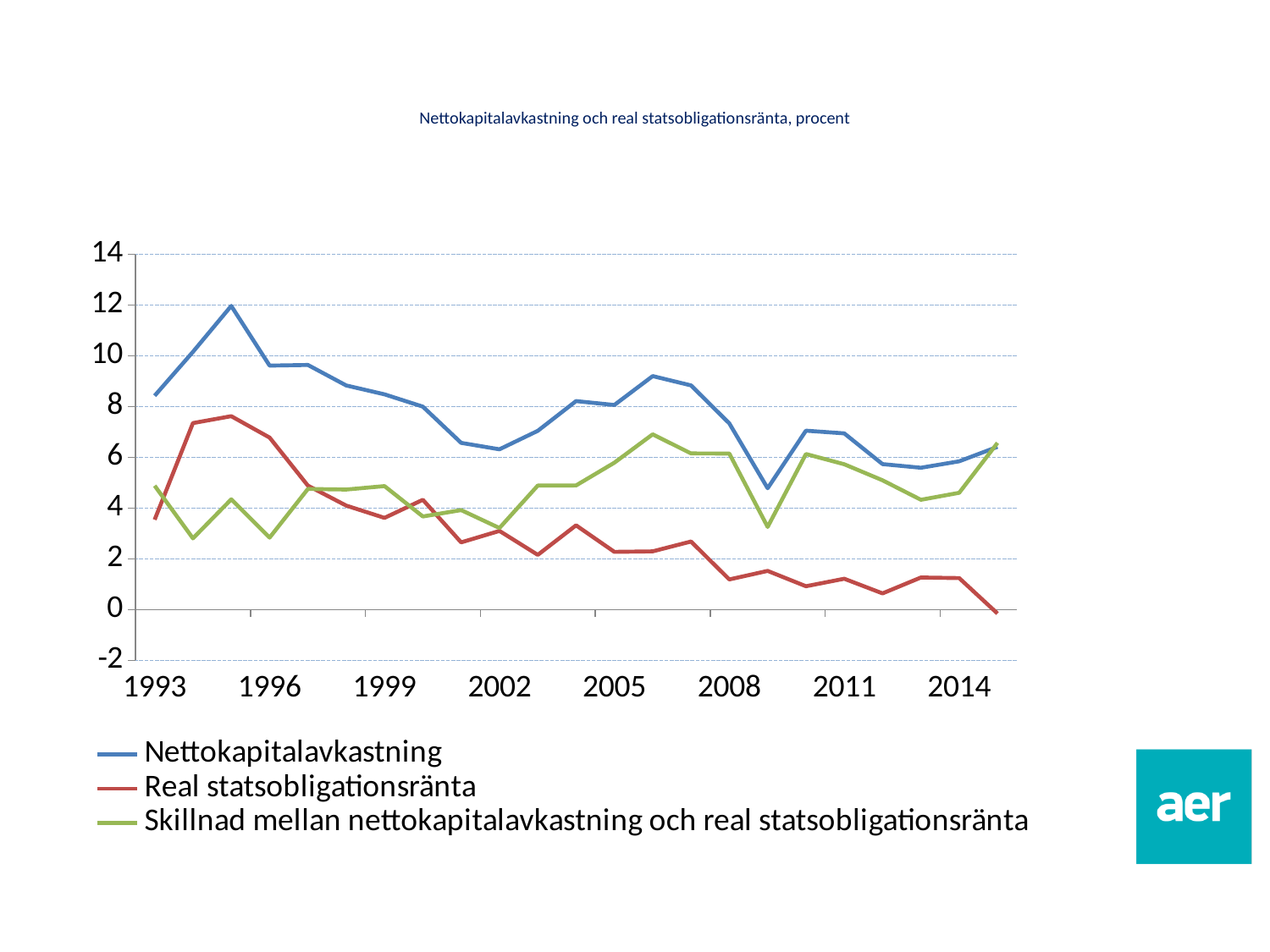
Is the value for Nettokapitalavkastning in 2009 greater or less than 6? less What kind of chart is shown on the slide? line chart Is the value for Real statsobligationsränta in 2008 greater or less than 2? less What is the title of the chart? Nettokapitalavkastning och real statsobligationsränta, procent In 1993, which is larger: Nettokapitalavkastning or Real statsobligationsränta? Nettokapitalavkastning In which year is Real statsobligationsränta at its lowest? 2015 Does Real statsobligationsränta generally rise or fall between 1995 and 2015? fall Which series is drawn in green? Skillnad mellan nettokapitalavkastning och real statsobligationsränta How many series does the legend list? 3 In which year does Nettokapitalavkastning reach its highest value? 1995 Is the value for Nettokapitalavkastning in 1993 greater or less than 8? greater